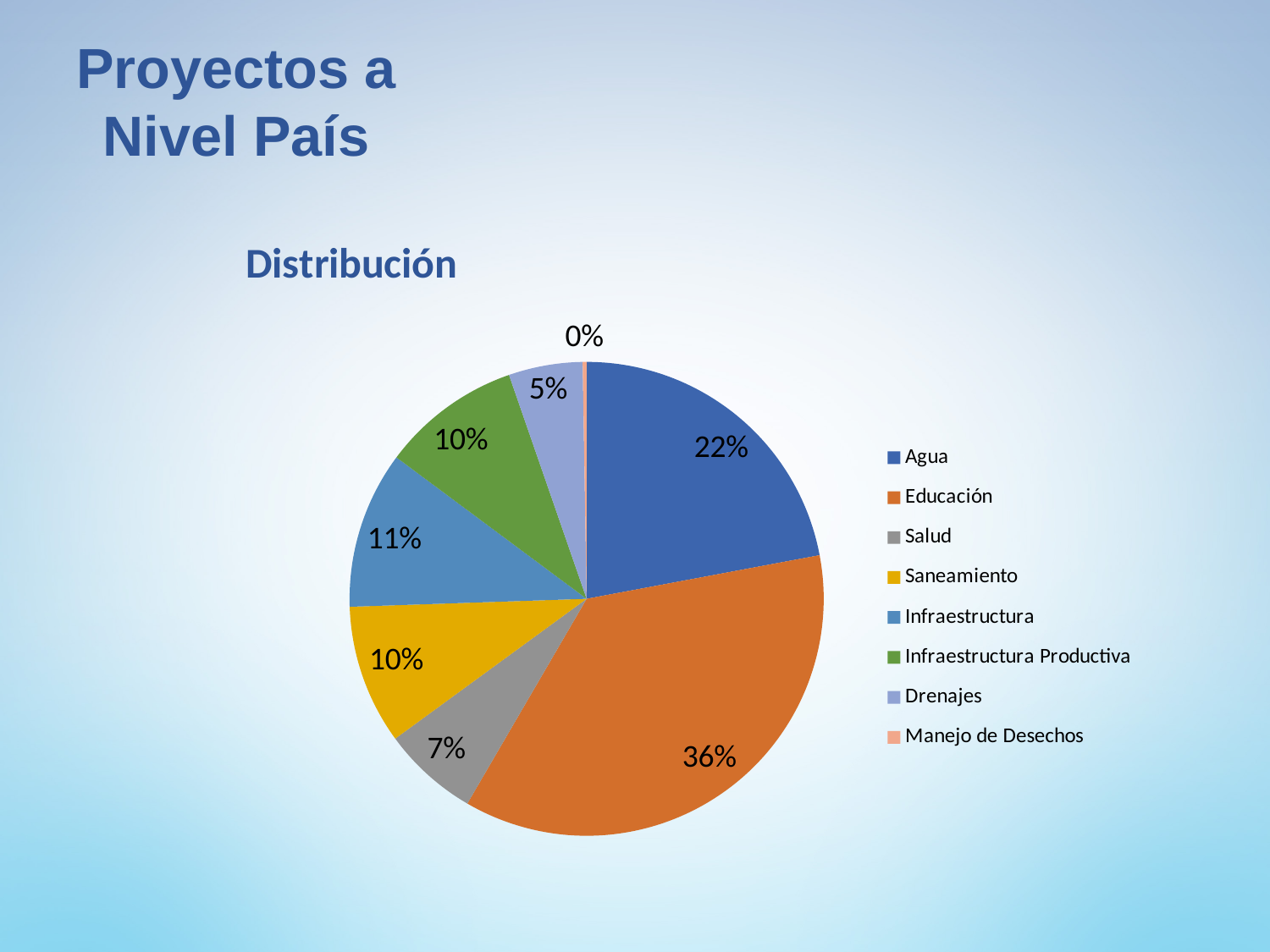
What is the value shown for Manejo de Desechos? 0% How many categories does the legend list? 8 What type of chart is shown on the slide? pie chart Which category has the largest share of the pie? Educación What share of the pie does Agua represent? 22% What is the title of the chart? Distribución Which is larger, the share for Infraestructura or the share for Salud? Infraestructura What is the value shown for Drenajes? 5% What share of the pie does Educación represent? 36% What is the difference between the shares of Educación and Agua? 14% What is the value shown for Salud? 7% Which category has the smallest share of the pie? Manejo de Desechos